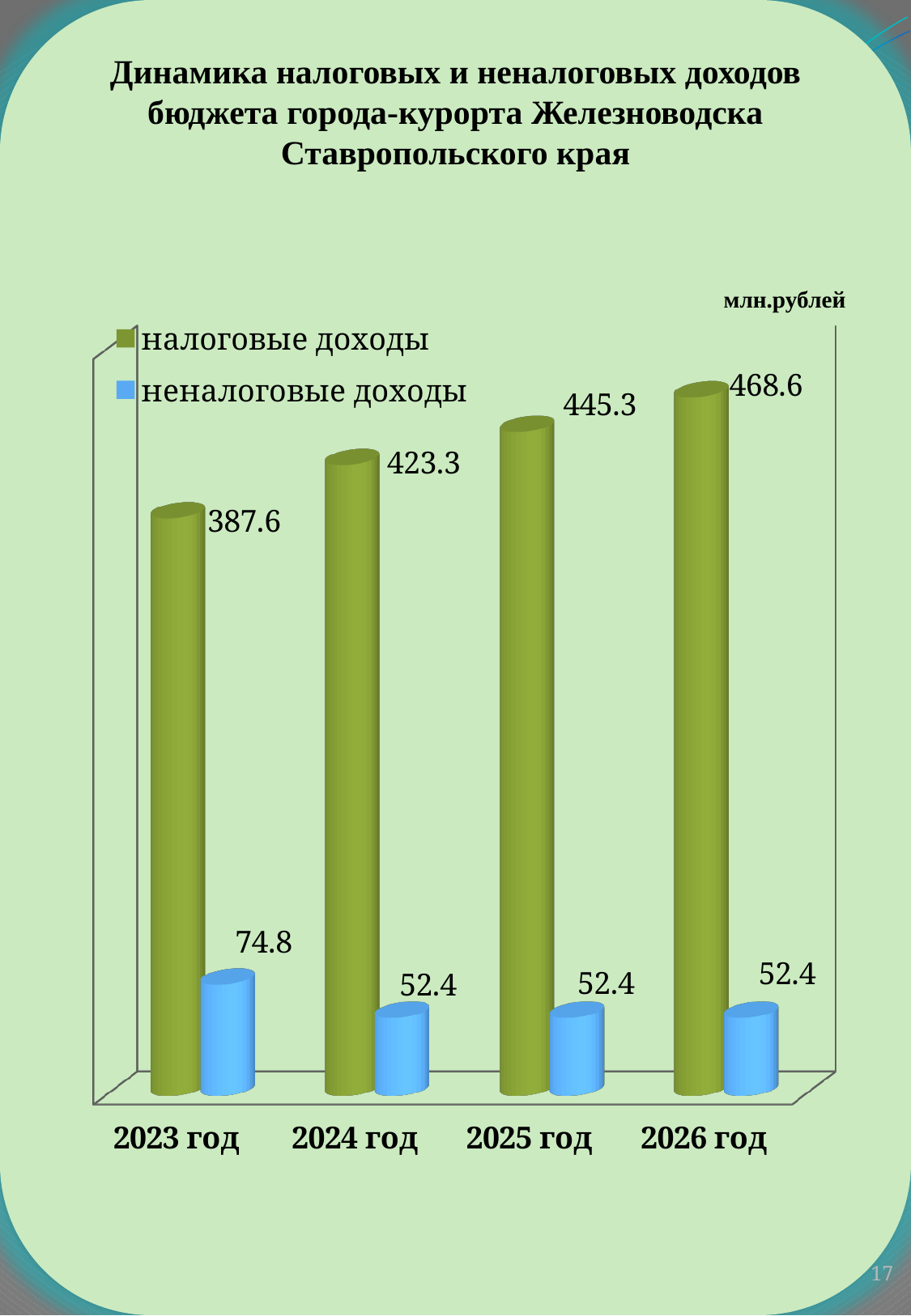
What is the value of налоговые доходы for 2026 год? 468.6 Which is larger: налоговые доходы in 2024 год or in 2025 год? 2025 год In which year are налоговые доходы highest? 2026 год What is the value of неналоговые доходы for 2023 год? 74.8 What is the difference between неналоговые доходы in 2023 год and 2024 год? 22.4 What is the value of неналоговые доходы for 2025 год? 52.4 In which year are налоговые доходы lowest? 2023 год What is the value of налоговые доходы for 2023 год? 387.6 What kind of chart is shown on the slide? Bar chart How many years are shown on the x axis? 4 What is the difference between налоговые доходы in 2026 год and 2023 год? 81.0 How many series does the legend list? 2